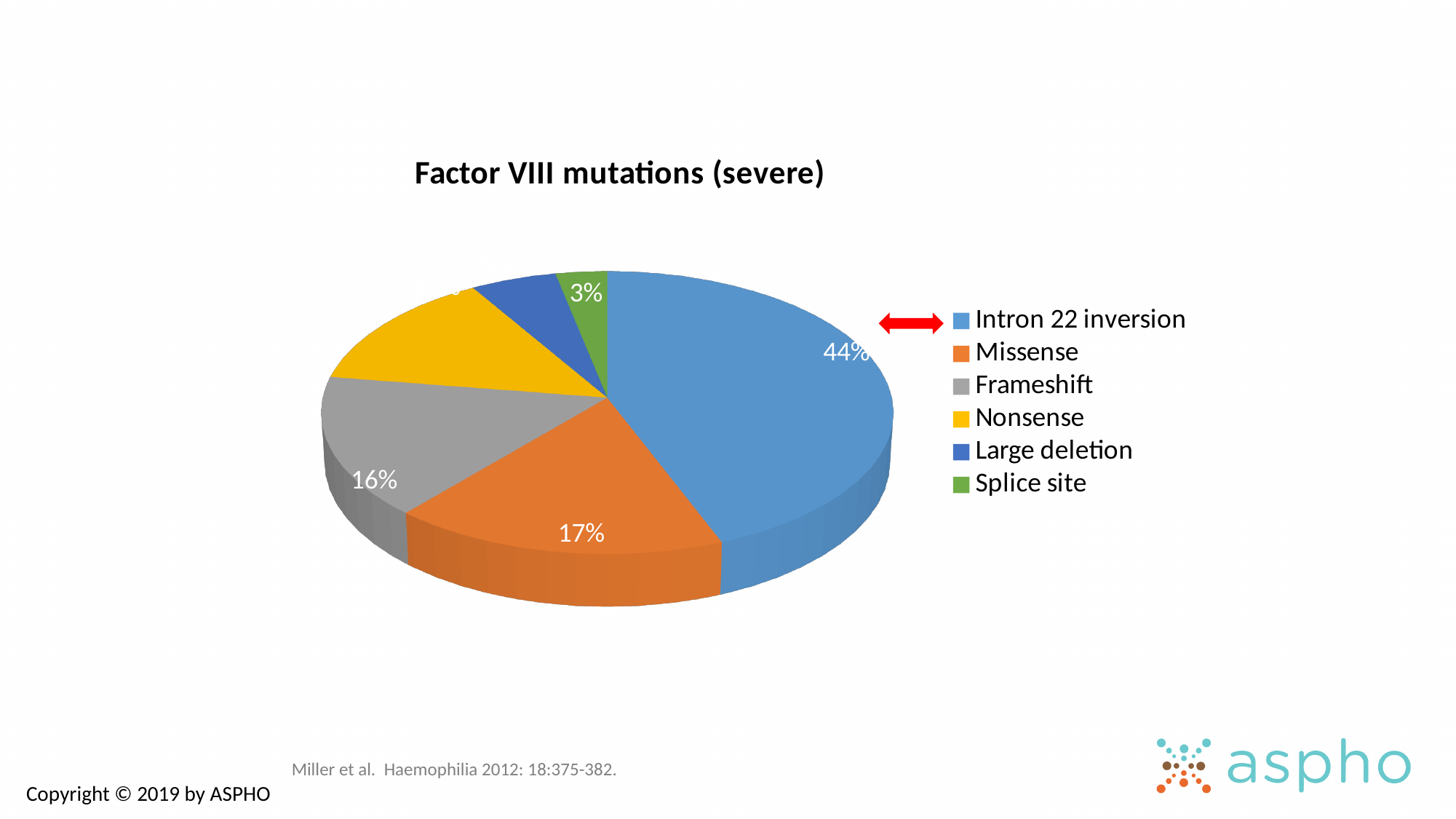
What percentage of the pie is labelled for Missense mutations? 17% Which mutation type is shown in yellow in the legend? Nonsense Which has a larger share, Missense or Frameshift? Missense What is the title of the chart? Factor VIII mutations (severe) What kind of chart is shown on the slide? Pie chart What percentage of severe Factor VIII mutations are Intron 22 inversions? 44% How many mutation categories are listed in the legend? 6 How many percentage points larger is the Intron 22 inversion share than the Missense share? 27 What share of severe Factor VIII mutations are Frameshift mutations? 16% What percentage is shown for Splice site mutations? 3% Which mutation type accounts for the largest share of the pie? Intron 22 inversion Which mutation type accounts for the smallest share of the pie? Splice site